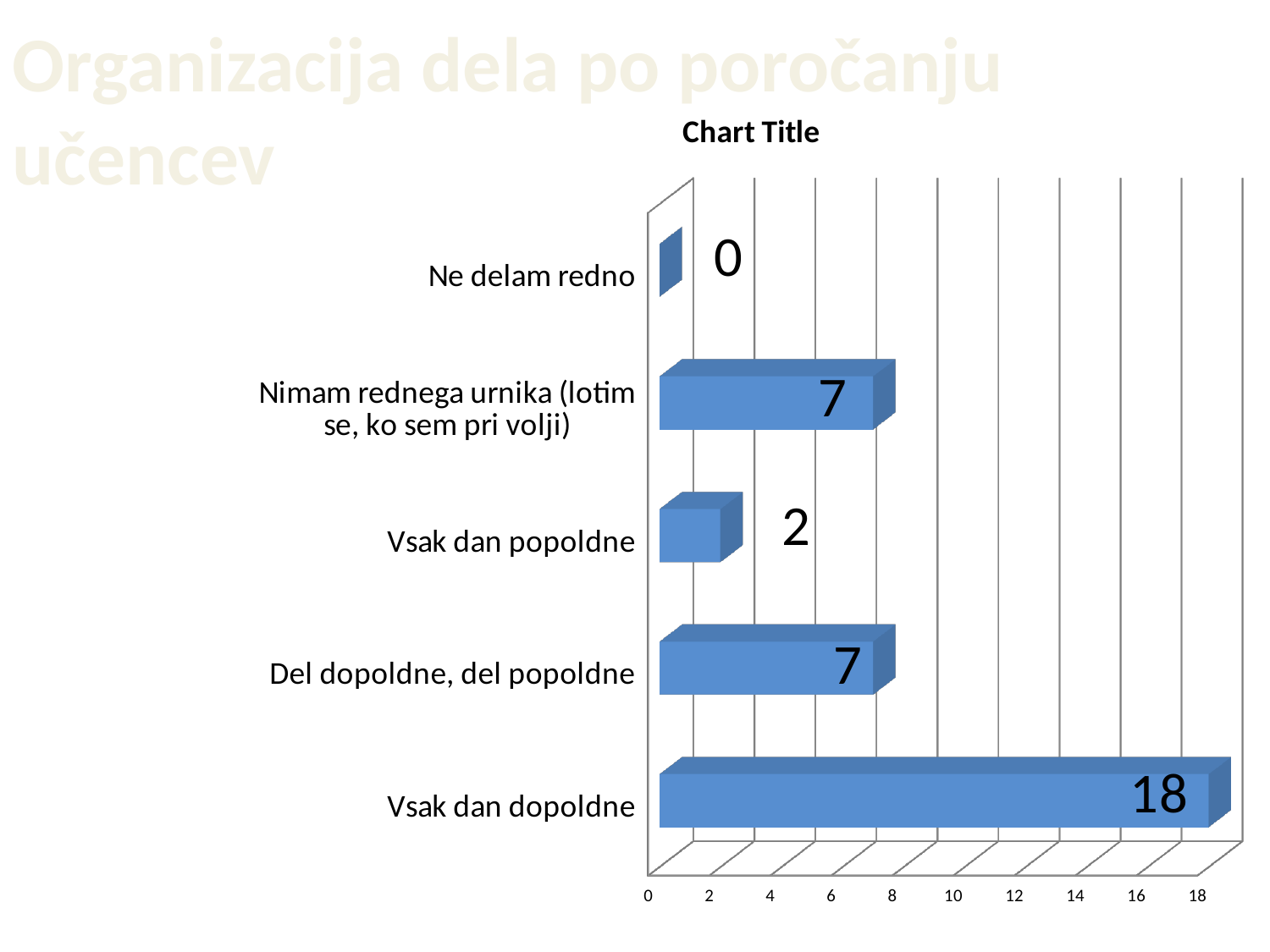
What kind of chart is shown on the slide? bar chart Which category has the lowest value? Ne delam redno Is the value for Vsak dan dopoldne greater or less than 10? greater What is the value for Del dopoldne, del popoldne? 7 How many categories are shown in the chart? 5 What is the value for Ne delam redno? 0 What is the title of the chart? Chart Title What is the value for Vsak dan popoldne? 2 Which is larger, the value for Vsak dan popoldne or the value for Nimam rednega urnika (lotim se, ko sem pri volji)? Nimam rednega urnika (lotim se, ko sem pri volji) What is the value for Vsak dan dopoldne? 18 Which category has the highest value? Vsak dan dopoldne What is the difference between the values for Vsak dan dopoldne and Del dopoldne, del popoldne? 11